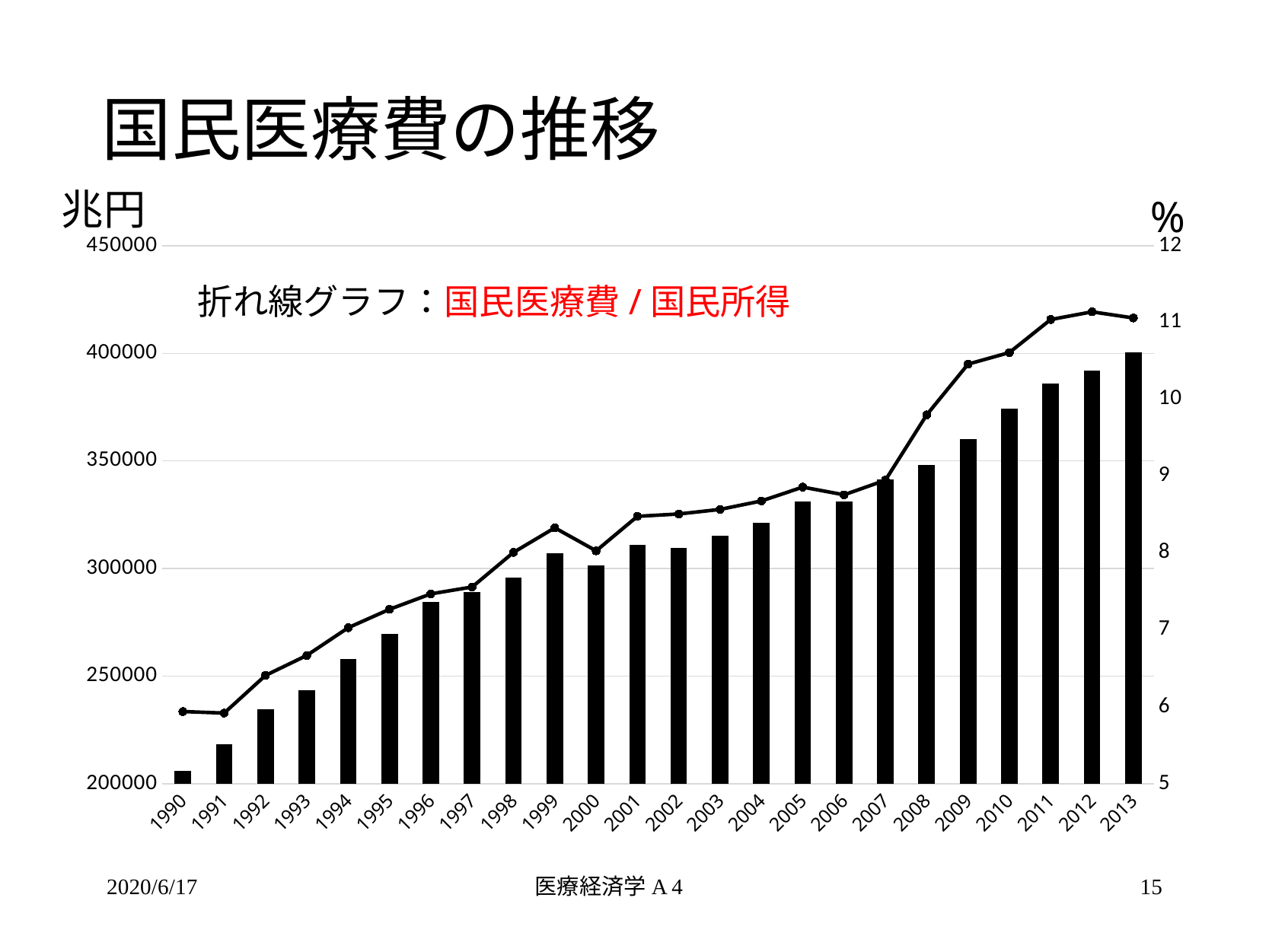
According to the annotation on the slide, what does the line graph represent? 国民医療費 / 国民所得 Do the bar values generally rise or fall from 1990 to 2013? Rise How many years are shown on the x axis of the chart? 24 Is the line value for 2008 greater or less than 9%? greater Is the bar value for 1995 greater or less than 300000? less Which year has the higher line value, 1999 or 2000? 1999 Is the bar value for 2001 greater or less than 300000? greater What type of chart is shown on the slide? A combined bar and line chart Which year has the tallest bar in the chart? 2013 Which year has the shortest bar in the chart? 1990